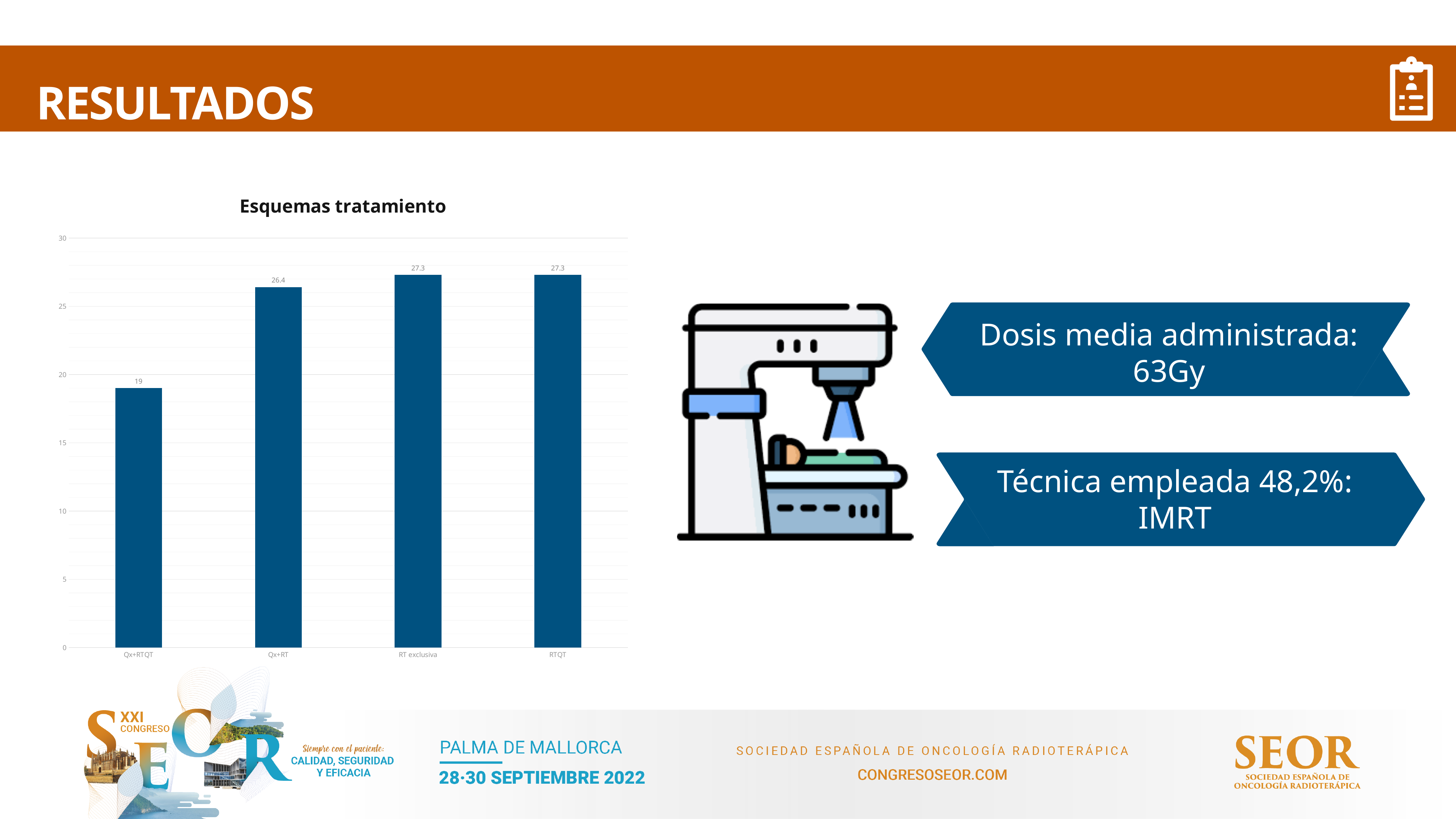
What is the title of the chart on the slide? Esquemas tratamiento What is the value for Qx+RTQT in the Esquemas tratamiento chart? 19 What is the value for Qx+RT in the Esquemas tratamiento chart? 26.4 Is the value for Qx+RTQT greater or less than 20? less What is the value for RT exclusiva in the Esquemas tratamiento chart? 27.3 What kind of chart is shown on the slide? bar chart What is the value for RTQT in the Esquemas tratamiento chart? 27.3 Which category has the lowest value in the Esquemas tratamiento chart? Qx+RTQT What is the difference between the values for Qx+RT and Qx+RTQT? 7.4 Which is larger, the value for Qx+RT or the value for Qx+RTQT? Qx+RT What is the difference between the values for RT exclusiva and Qx+RT? 0.9 How many categories are shown in the Esquemas tratamiento chart? 4